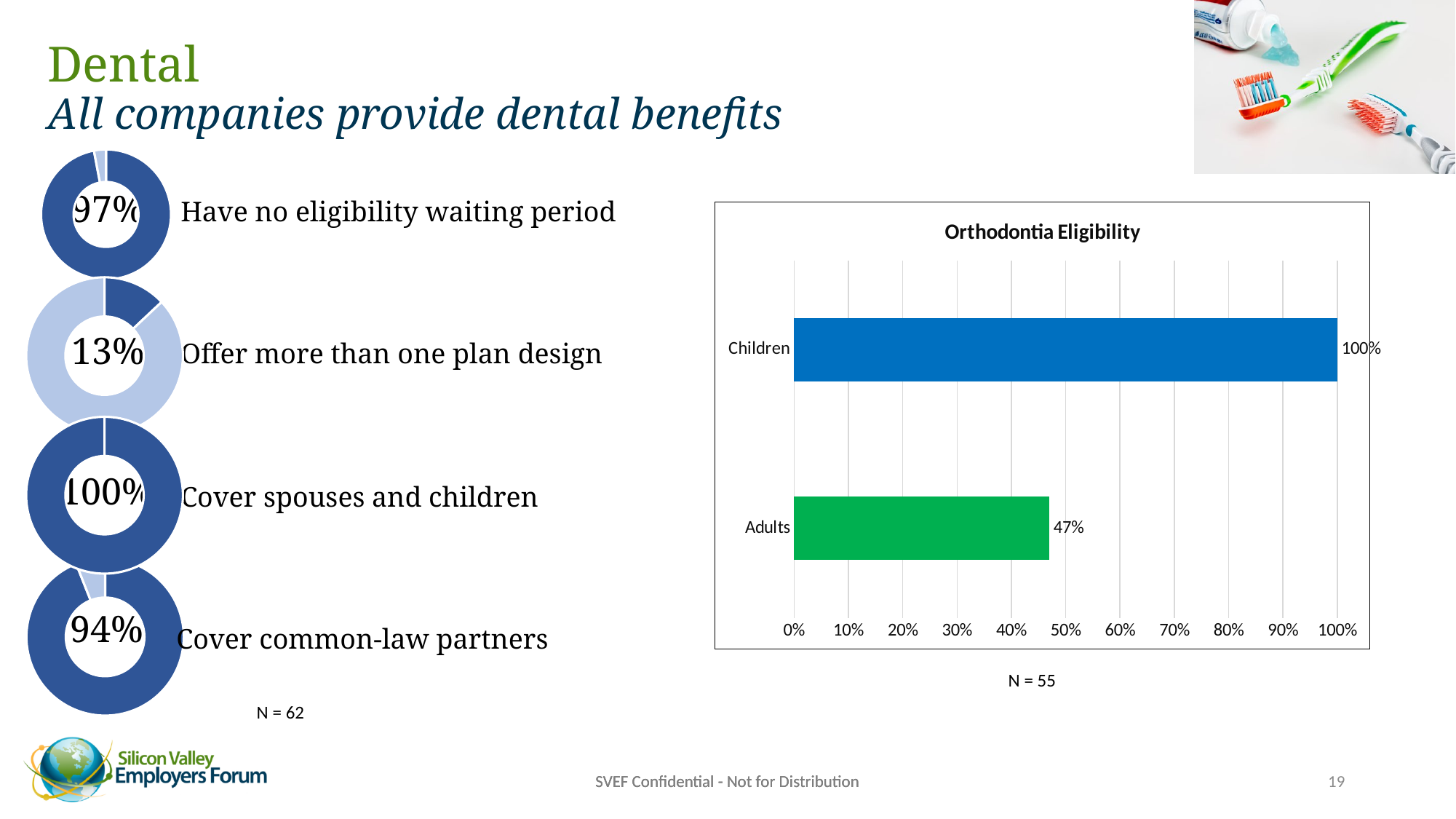
In the donut charts on the left, what percentage of companies offer more than one plan design? 13% In the Orthodontia Eligibility chart, what is the value for Children? 100% In the Orthodontia Eligibility chart, is the value for Adults greater or less than 50%? less In the Orthodontia Eligibility chart, what is the difference between the values for Children and Adults? 53% In the Orthodontia Eligibility chart, which category has the highest value? Children In the Orthodontia Eligibility chart, which category has the lowest value? Adults In the donut charts on the left, what percentage of companies have no eligibility waiting period? 97% In the Orthodontia Eligibility chart, what is the value for Adults? 47% What kind of chart is the Orthodontia Eligibility chart? bar chart In the donut charts on the left, what percentage of companies cover common-law partners? 94% What is the sample size (N) noted below the Orthodontia Eligibility chart? N = 55 How many categories are shown in the Orthodontia Eligibility chart? 2